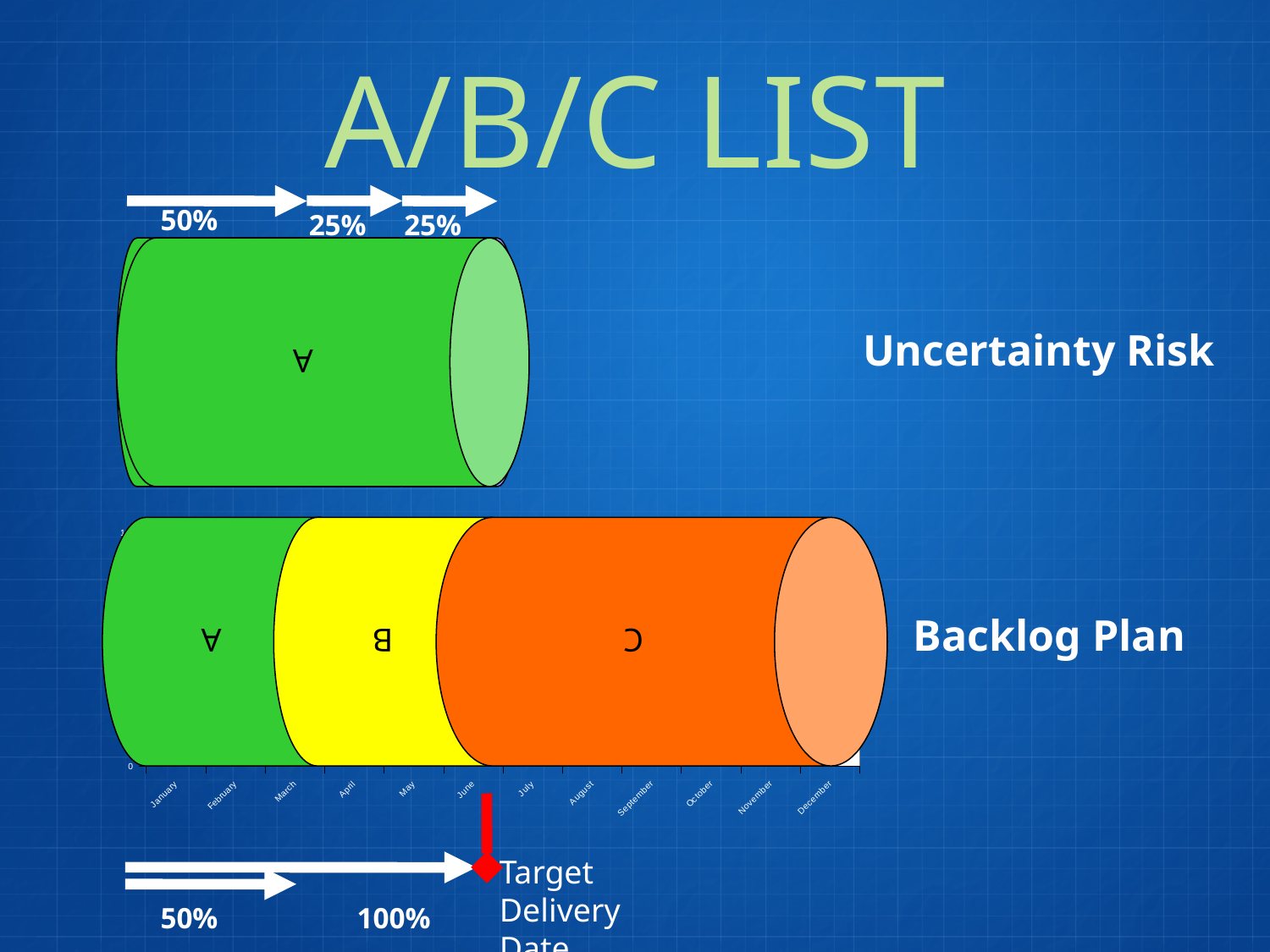
How many month labels are shown on the x axis of the Backlog Plan chart? 12 In the Backlog Plan chart, which segment is longer, A or C? C What kind of chart is the Backlog Plan chart at the bottom of the slide? bar chart What is the first category label on the x axis of the Backlog Plan chart? January In the Backlog Plan chart, which segment is the longest? C In the Backlog Plan chart, which segment is longer, B or C? C What is the label of the single segment in the Uncertainty Risk chart at the top of the slide? A What is the title of the slide containing the charts? A/B/C LIST What is the last category label on the x axis of the Backlog Plan chart? December In the Backlog Plan chart, what colour is segment B? yellow In the Backlog Plan chart, how many segments make up the stacked bar? 3